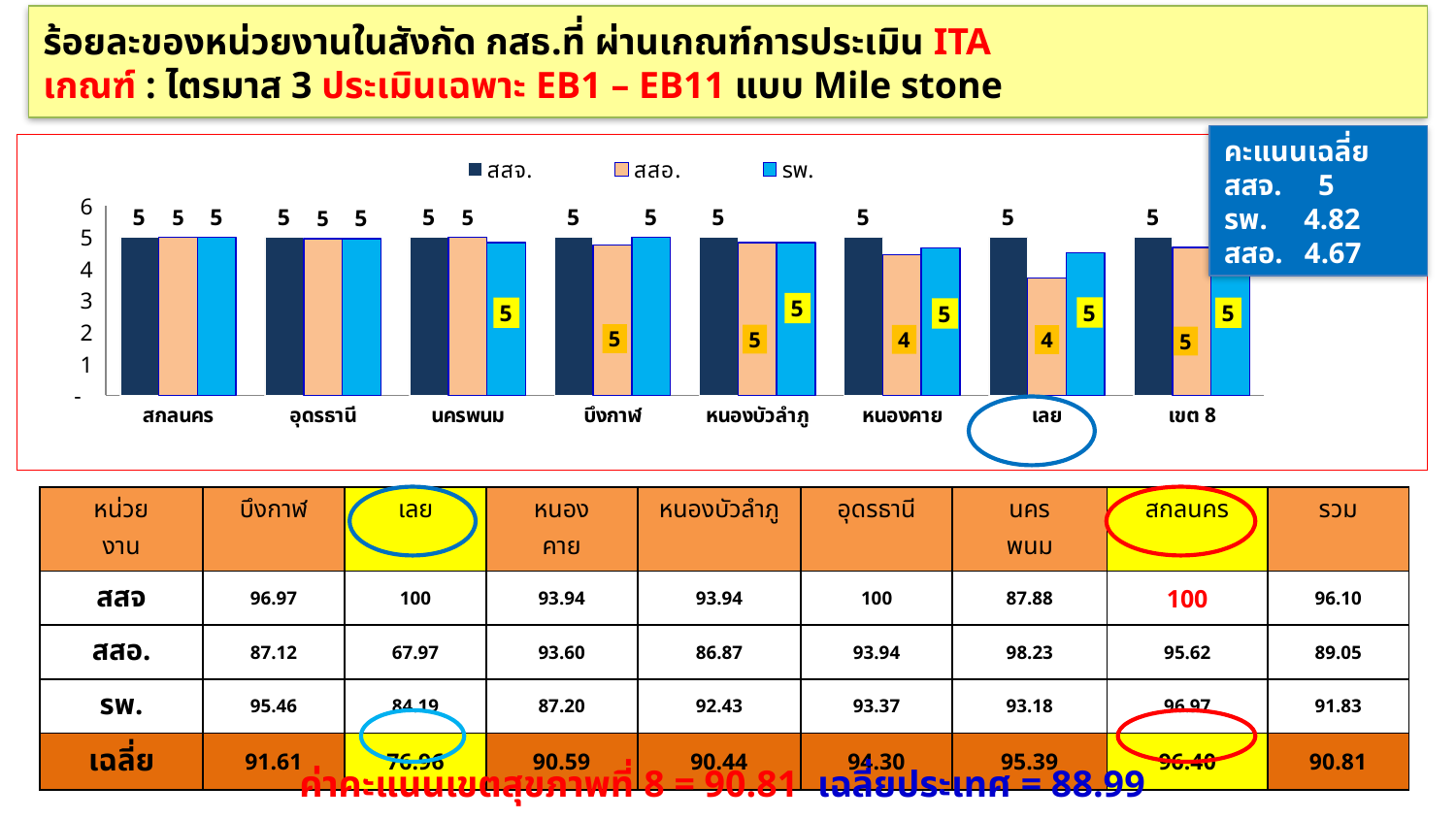
Is the value of รพ. for หนองคาย greater or less than 4? greater Which category has the lowest สสอ. bar? เลย What is the value of สสจ. for สกลนคร? 5 What are the three series names listed in the chart legend? สสจ., สสอ., รพ. For เลย, which is larger: the สสอ. bar or the รพ. bar? รพ. Is the value of สสอ. for บึงกาฬ greater or less than 4? greater What is the value of สสจ. for เขต 8? 5 How many categories are shown along the x axis of the chart? 8 What type of chart is shown on the slide? bar chart According to the คะแนนเฉลี่ย box on the chart, what is the average score for รพ.? 4.82 Is the value of สสอ. for เลย greater or less than 4? less How many series does the chart legend list? 3